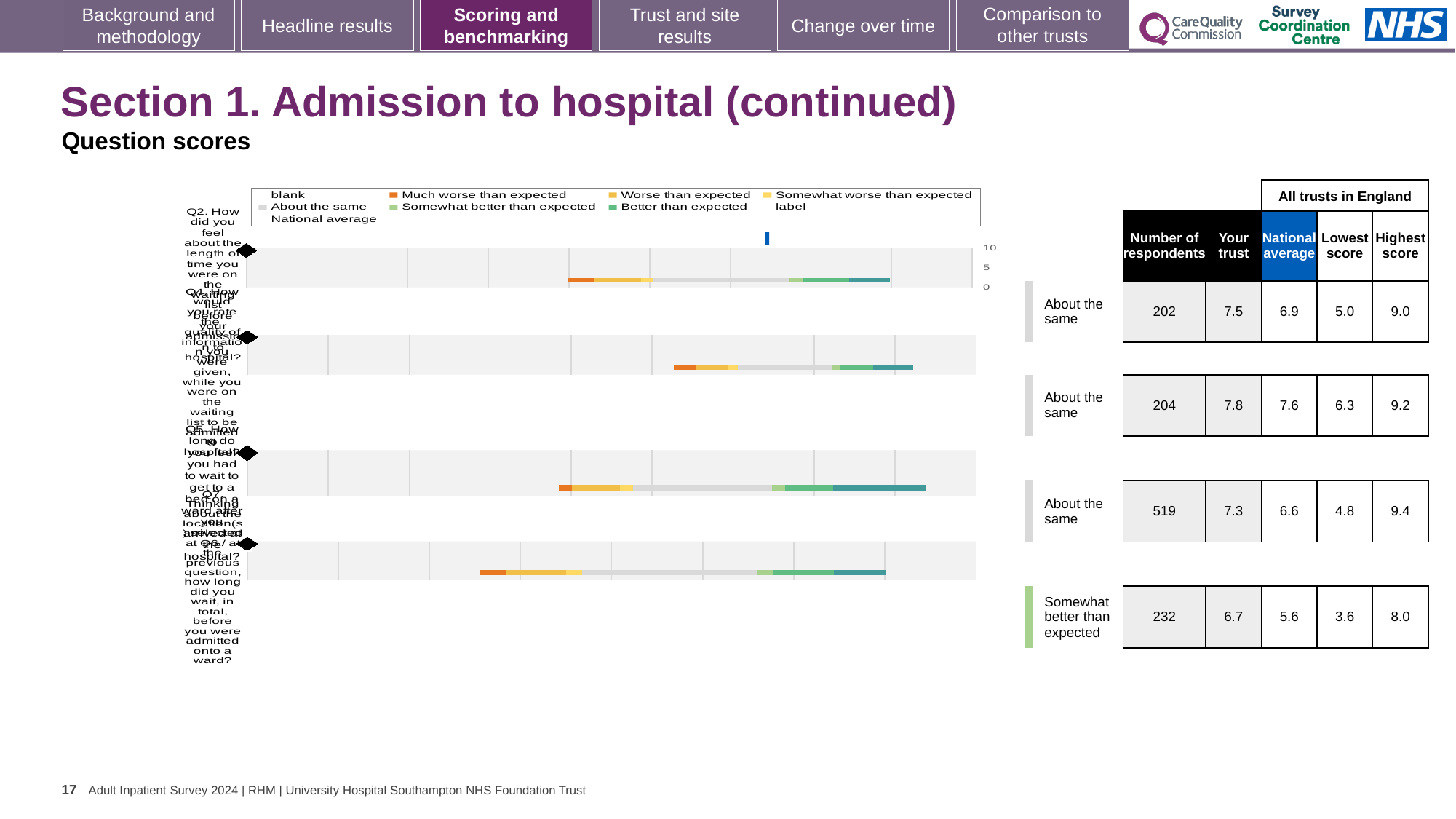
What is the difference between the 'Your trust' score and the national average for the first row (Q2)? 0.6 In the table next to the chart, what is the 'Your trust' score for the second row (Q4)? 7.8 Which row has the lowest 'Lowest score' value in the table? Q7 (fourth row), 3.6 In the table next to the chart, what is the number of respondents for the first row (Q2)? 202 What kind of chart is shown on the slide? bar chart How many rows are rated 'About the same'? 3 In the table next to the chart, what is the national average for the third row (Q5)? 6.6 In the table next to the chart, what is the highest score for the fourth row (Q7)? 8.0 Which row has the highest 'Your trust' score in the table? Q4 (second row), 7.8 For the third row (Q5), which is larger: the 'Your trust' score or the national average? Your trust (7.3) Which row is rated 'Somewhat better than expected'? Q7 (fourth row) How many question rows are plotted in the chart? 4